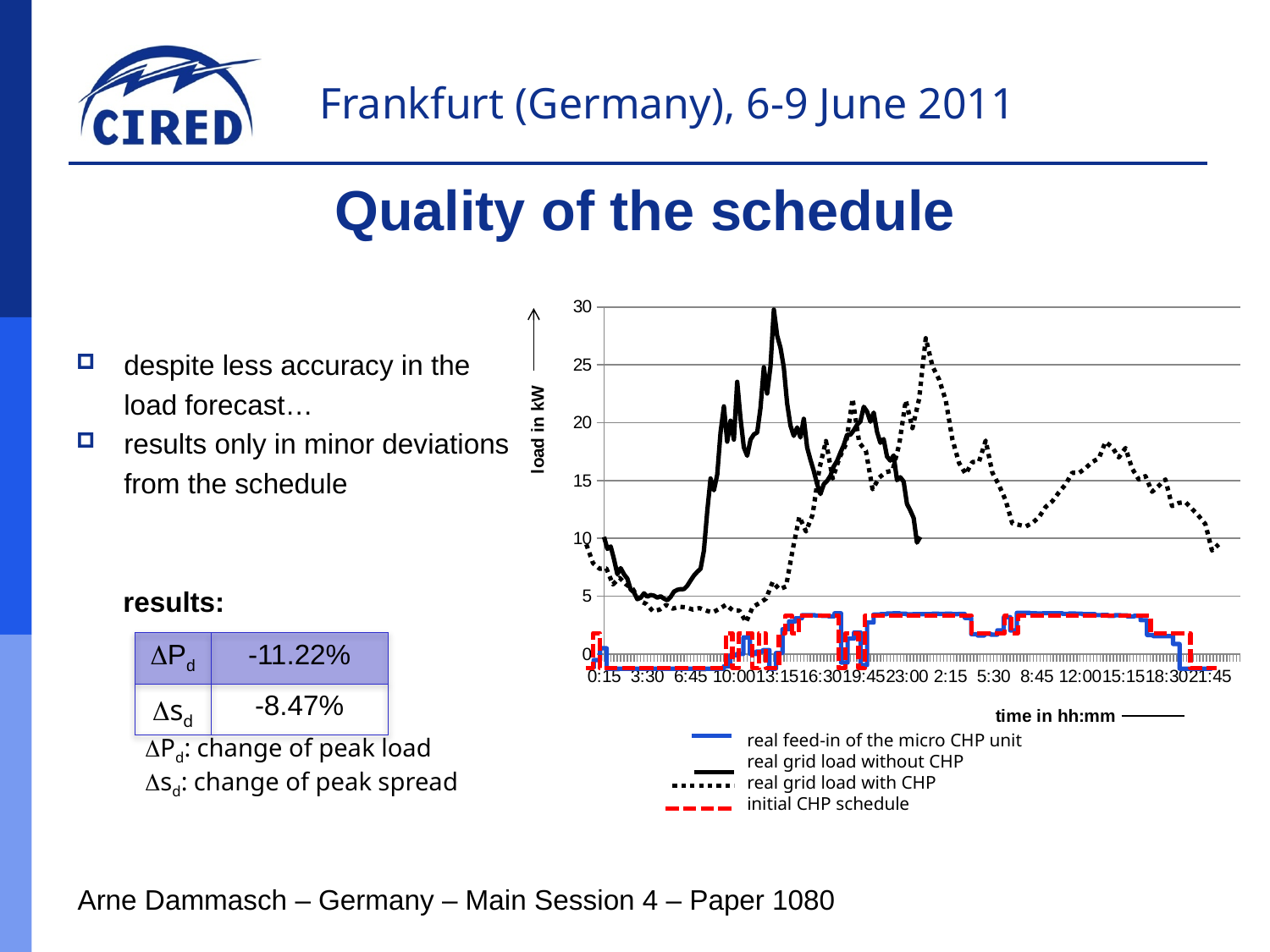
What type of chart is shown on the slide? line chart How many time labels are shown along the x axis of the chart? 15 Is the peak value of the 'real grid load without CHP' series greater or less than 25 kW? greater Which series is drawn as a red dashed line in the chart? initial CHP schedule Is the value of 'real grid load without CHP' at 3:30 greater or less than 10 kW? less What is the highest value shown on the vertical axis of the chart? 30 Does the 'real grid load without CHP' series rise or fall between 6:45 and 10:00? rise How many series does the chart legend list? 4 Is the peak value of the 'real grid load with CHP' series greater or less than 25 kW? greater What is the label of the vertical axis of the chart? load in kW Which series reaches a higher peak: 'real grid load without CHP' or 'real grid load with CHP'? real grid load without CHP